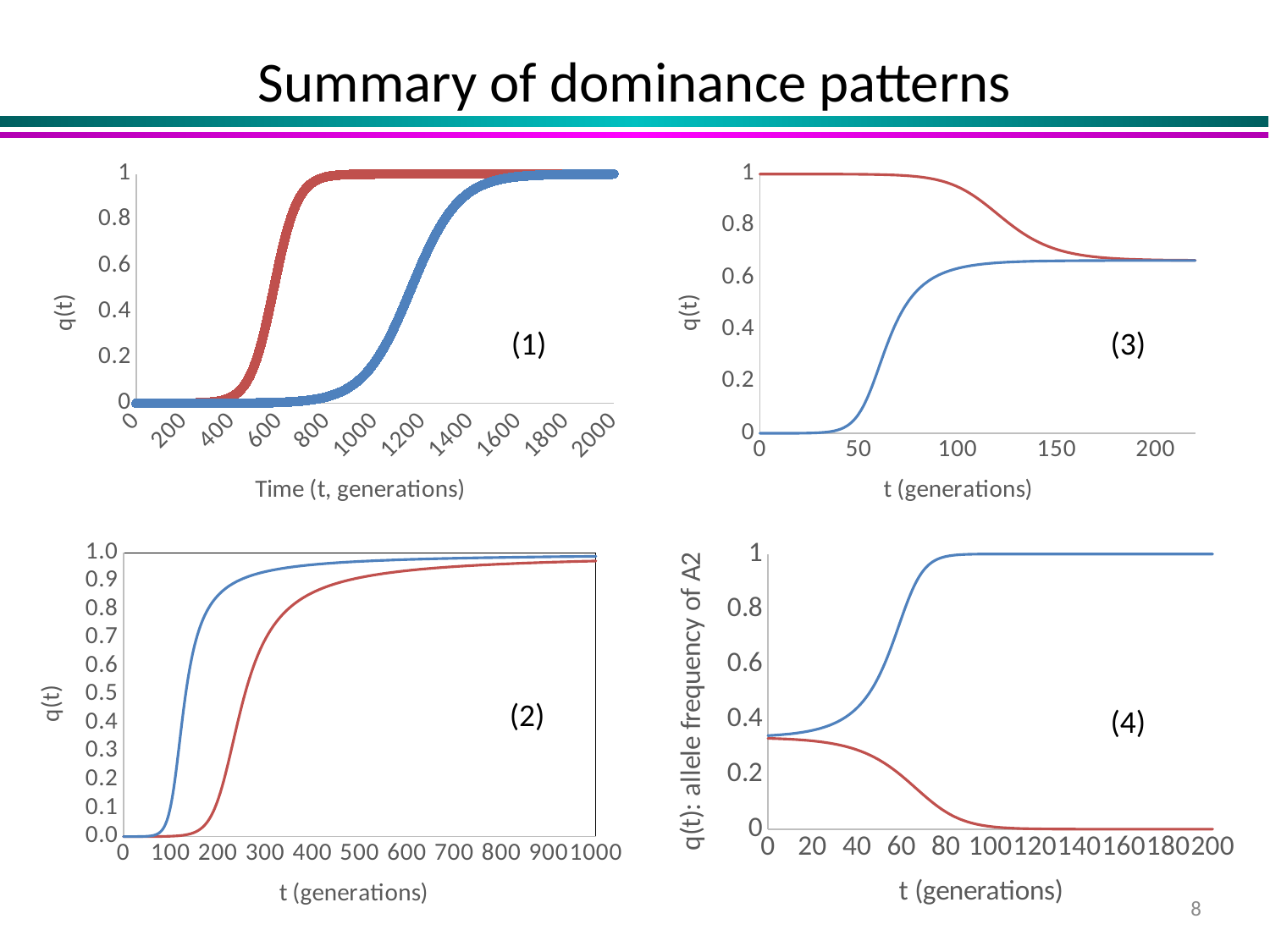
In chart (4), does the blue line rise or fall as t increases? rise In chart (4), is the value of the red line at t = 200 greater or less than 0.2? less How many charts are shown on the slide? 4 In chart (1), which line reaches q(t) = 1 first, the red line or the blue line? red line What is the y-axis label of chart (4)? q(t): allele frequency of A2 In chart (2), which line rises earlier, the blue line or the red line? blue line What is the x-axis label of chart (1)? Time (t, generations) In chart (3), is the value of the blue line at t = 200 greater or less than 0.6? greater What kind of chart is chart (1)? line chart In chart (3), what is the value of the red line at t = 0? 1 In chart (1), is the value of the blue line at t = 800 greater or less than 0.2? less In chart (3), does the red line rise or fall as t increases? fall